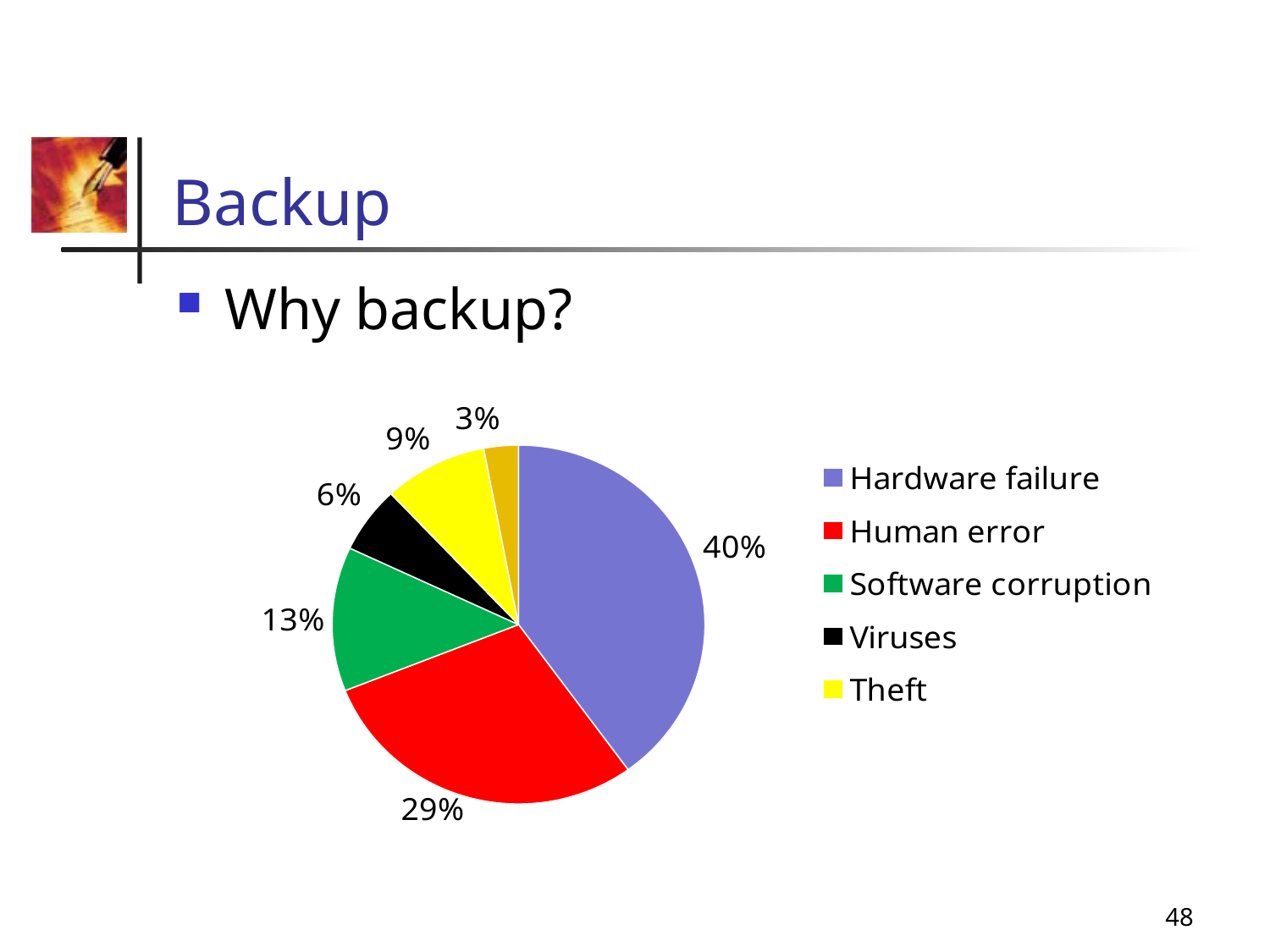
What percentage of the pie is Theft? 9% Which is larger, the share for Theft or the share for Viruses? Theft What percentage of the pie is Human error? 29% Which of the legend categories has the smallest share of the pie? Viruses What percentage of the pie is Viruses? 6% What percentage of the pie is Hardware failure? 40% What is the difference in percentage points between Hardware failure and Human error? 11 How many slices does the pie chart have? 6 What colour is the Software corruption slice? green What type of chart is shown on the slide? pie chart Which category has the largest share of the pie? Hardware failure What percentage of the pie is Software corruption? 13%